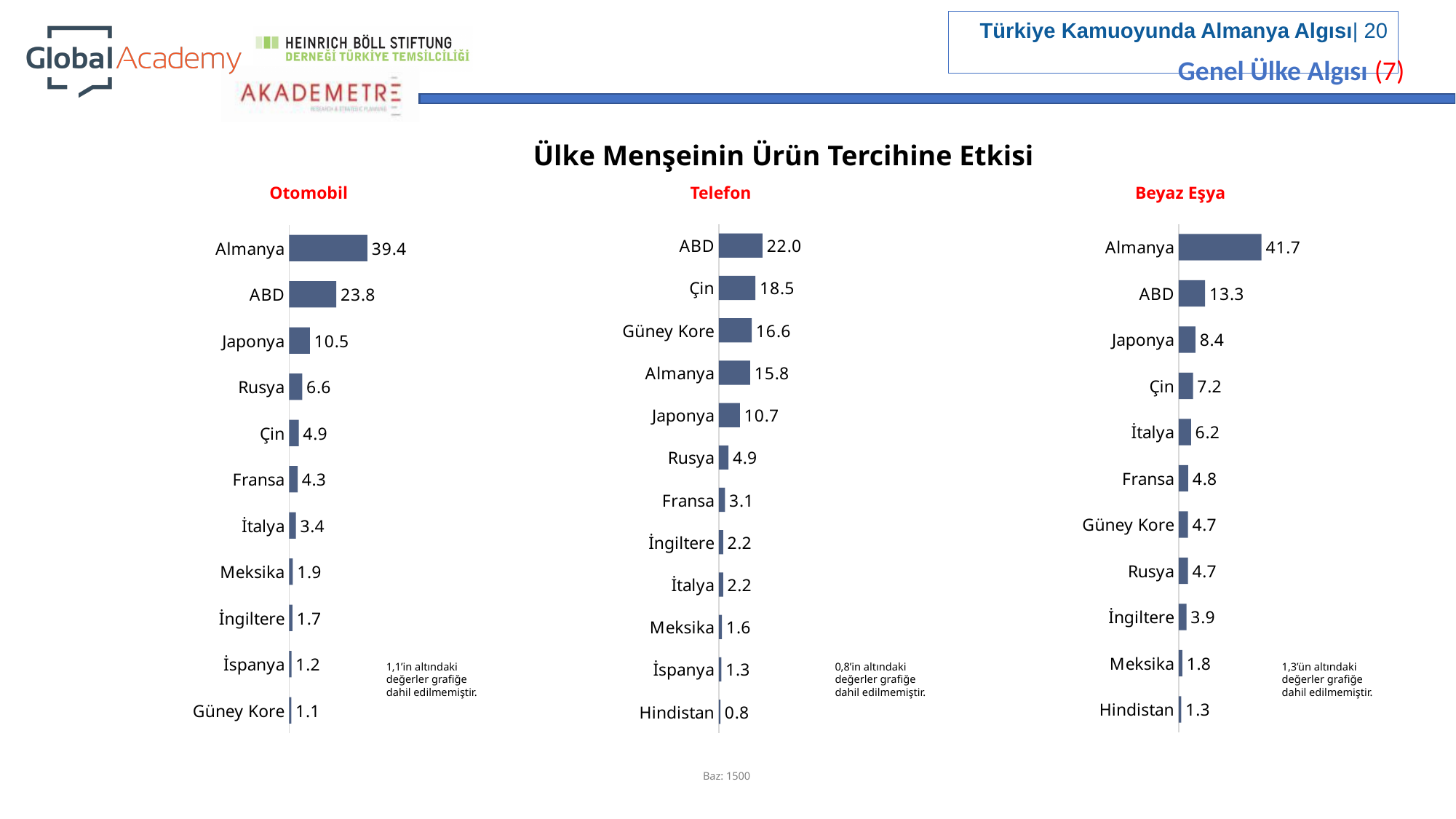
What type of chart is the Otomobil chart? Bar chart In the Otomobil chart, what is the value for Almanya? 39.4 In the Telefon chart, what is the value for Güney Kore? 16.6 What is the main title shown above the three charts? Ülke Menşeinin Ürün Tercihine Etkisi In the Otomobil chart, which country has the lowest value? Güney Kore In the Beyaz Eşya chart, what is the difference between the values for Almanya and ABD? 28.4 How many countries are shown in the Telefon chart? 12 In the Telefon chart, which is larger: the value for Çin or the value for Almanya? Çin How many countries are shown in the Beyaz Eşya chart? 11 In the Beyaz Eşya chart, what is the value for Japonya? 8.4 In the Telefon chart, which country has the highest value? ABD In the Otomobil chart, what is the difference between the values for ABD and Japonya? 13.3